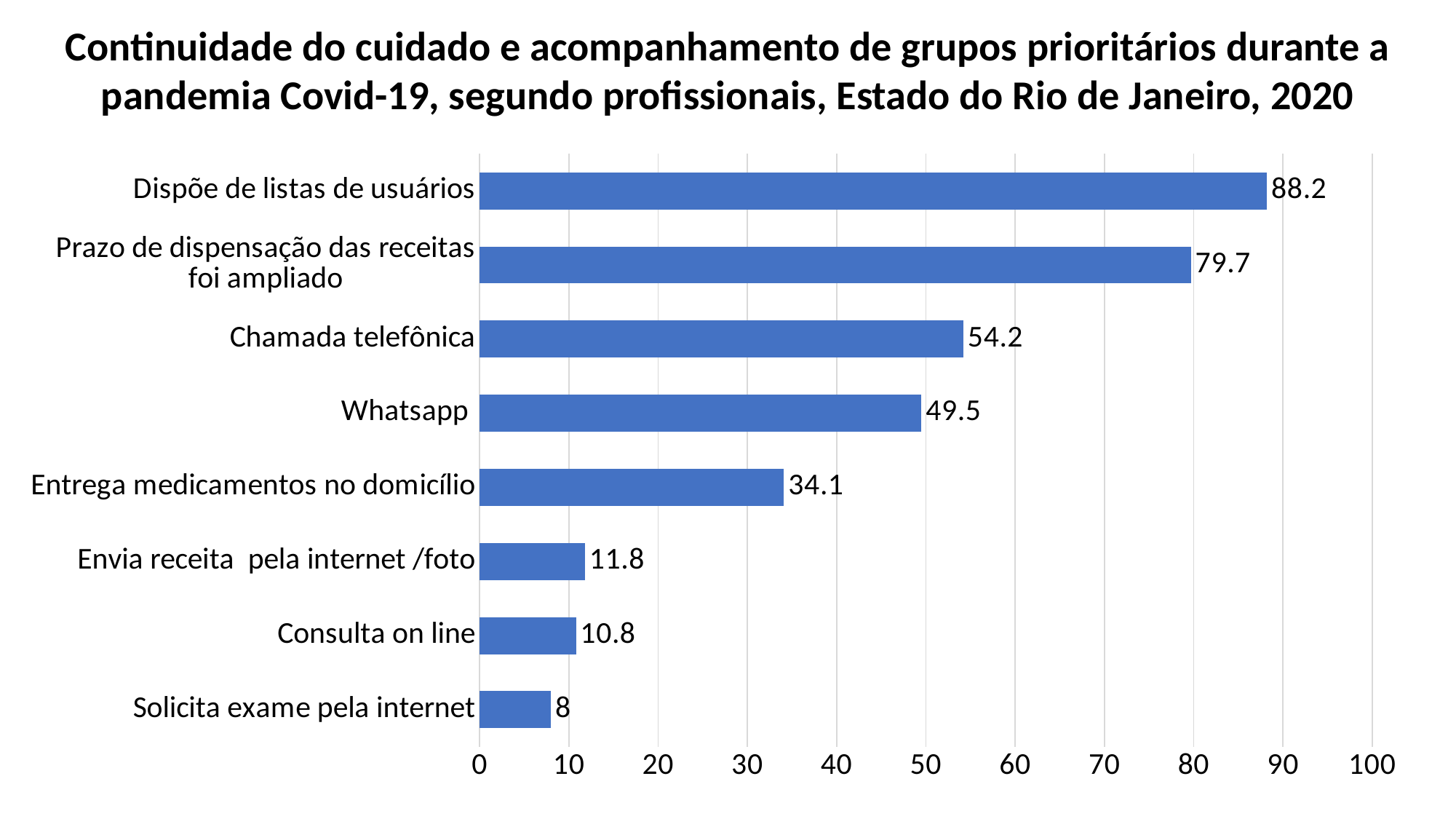
Which category has the highest value? Dispõe de listas de usuários What is the value for "Prazo de dispensação das receitas foi ampliado"? 79.7 How many categories are shown in the chart? 8 What is the value for "Dispõe de listas de usuários"? 88.2 What is the value for "Whatsapp"? 49.5 Is the value for "Entrega medicamentos no domicílio" greater or less than 40? less What is the value for "Solicita exame pela internet"? 8 Which is larger, the value for "Envia receita pela internet /foto" or "Consulta on line"? Envia receita pela internet /foto Which category has the lowest value? Solicita exame pela internet What is the maximum value shown on the horizontal axis? 100 What is the difference between the values for "Chamada telefônica" and "Whatsapp"? 4.7 What kind of chart is shown on the slide? bar chart